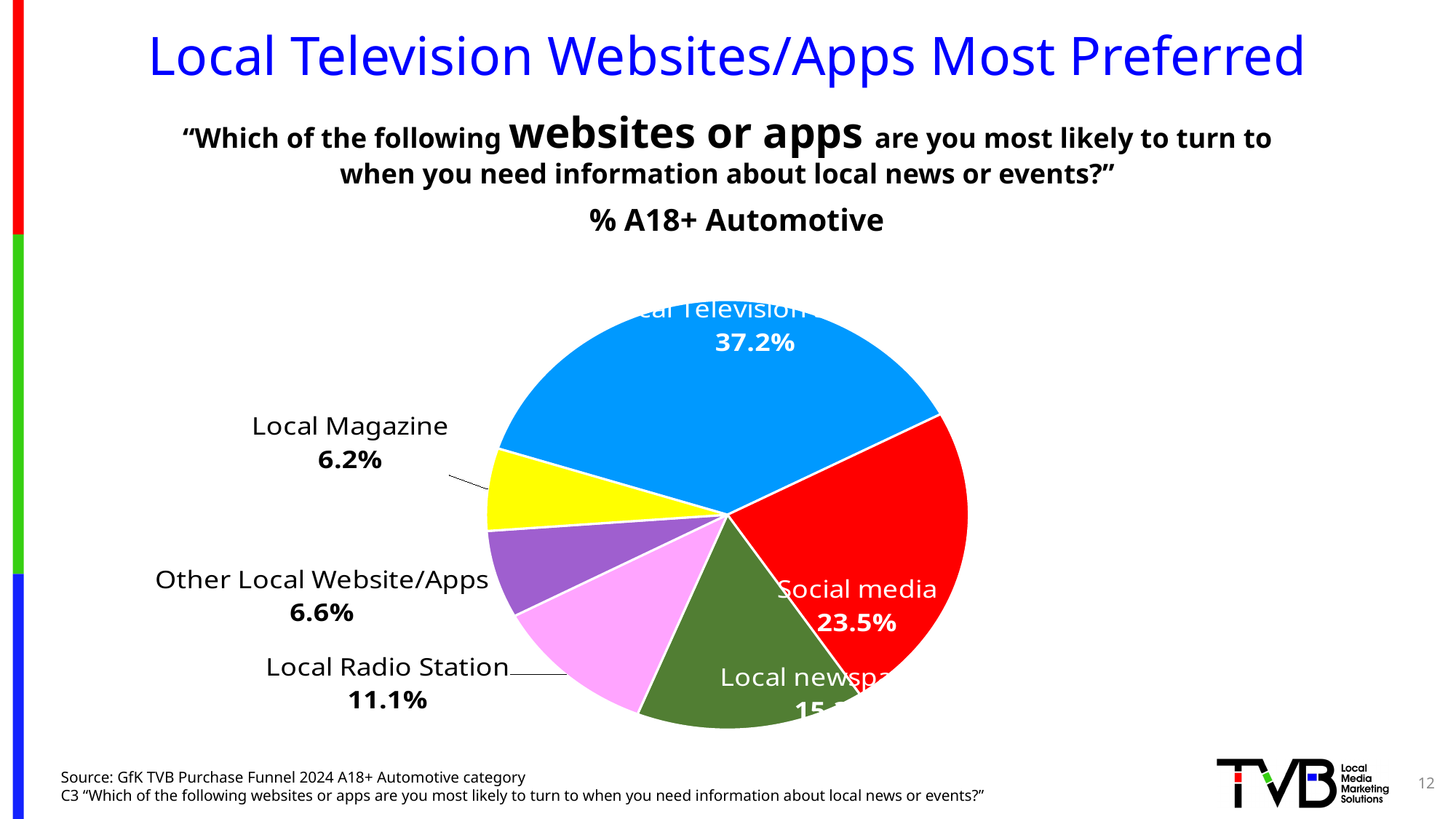
What is the difference in percentage points between Local Television and Social media? 13.7 Which is larger, Local Radio Station or Other Local Website/Apps? Local Radio Station How many slices does the pie chart have? 6 What colour is the Social media slice? red Which category has the largest slice of the pie? Local Television What kind of chart is shown on the slide? pie chart What is the value for Local Magazine? 6.2% What is the value for Social media? 23.5% Which category has the smallest slice of the pie? Local Magazine What is the value for Other Local Website/Apps? 6.6% What percentage of the pie is Local Television? 37.2% What is the value for Local Radio Station? 11.1%